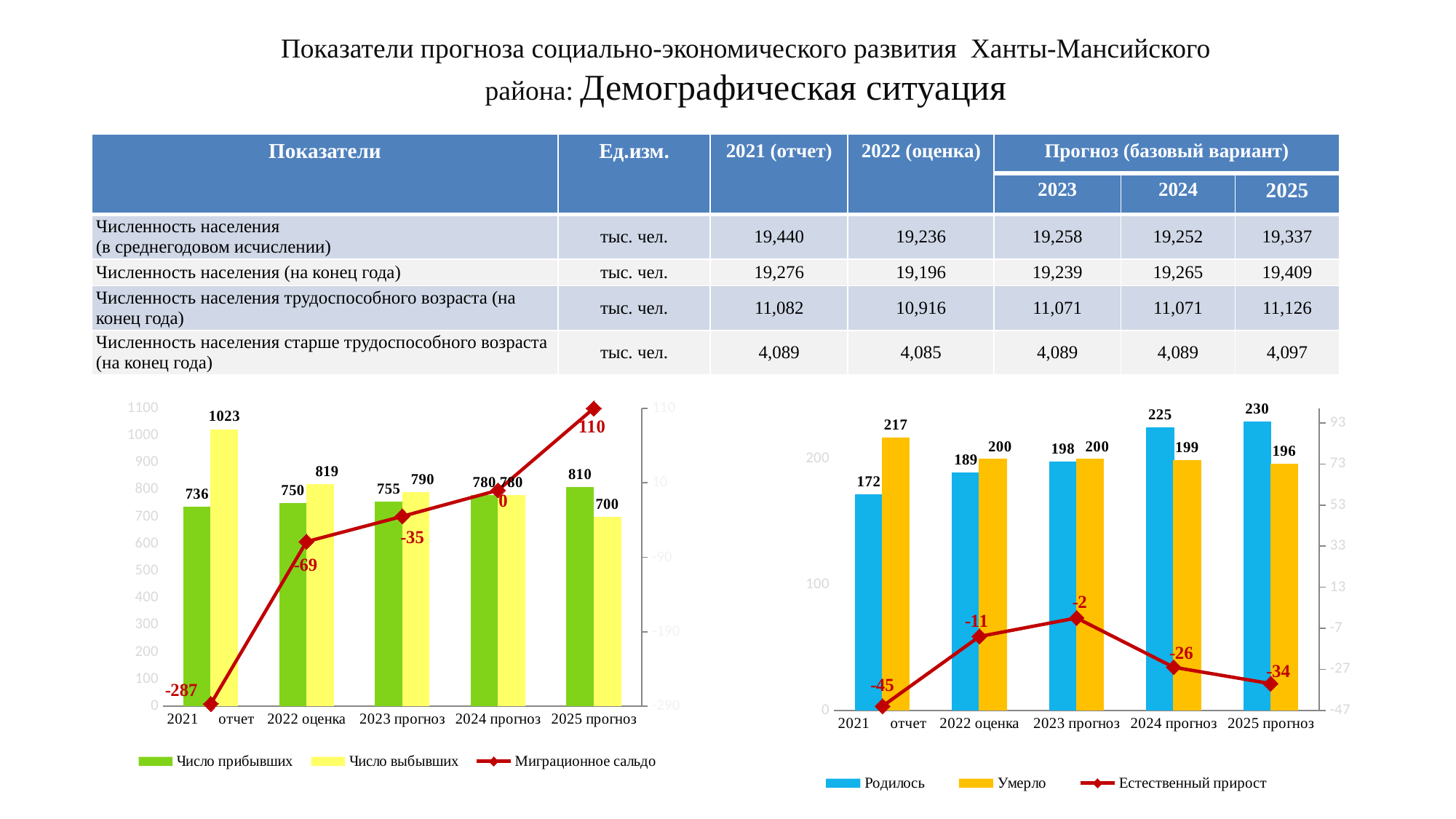
In the right chart, how many years are shown on the x axis? 5 In the left chart, what is the value of Число выбывших for 2025 прогноз? 700 In the left chart, what is the value of Число прибывших for 2021 отчет? 736 In the right chart, what is the value of Умерло for 2021 отчет? 217 In the left chart, what is the Миграционное сальдо value for 2023 прогноз? -35 In the left chart, in which year is Число выбывших highest? 2021 отчет In the right chart, in which year is Естественный прирост lowest? 2021 отчет In the right chart, what is the value of Родилось for 2024 прогноз? 225 In the left chart, does Миграционное сальдо rise or fall from 2021 to 2025? rise In the right chart, which is larger in 2025 прогноз: Родилось or Умерло? Родилось In the left chart, how many series does the legend list? 3 In the left chart, what is the difference between Число выбывших and Число прибывших in 2021 отчет? 287